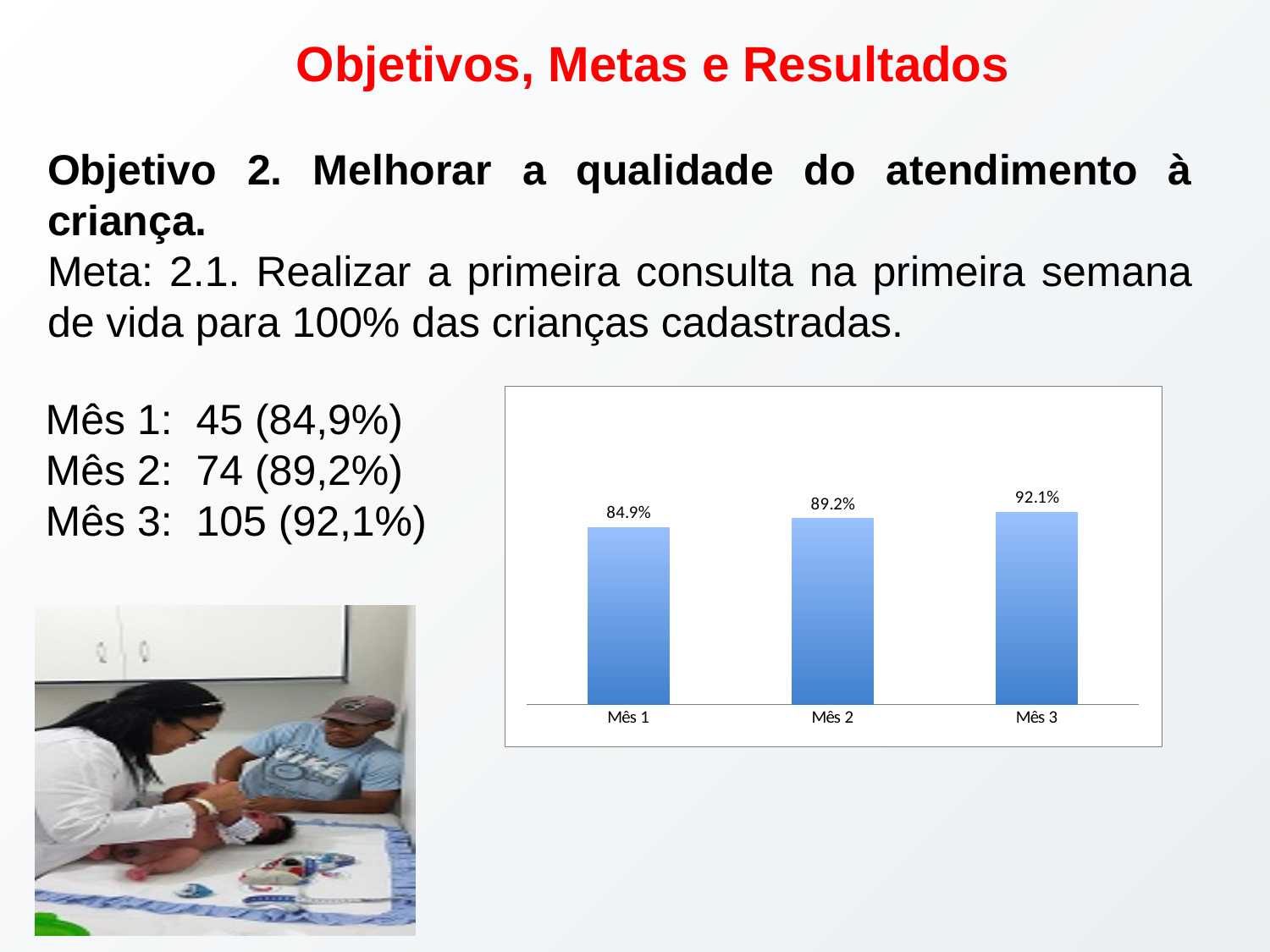
What is the value shown for Mês 3 in the chart? 92.1% Which month has the highest value in the chart? Mês 3 Do the values rise or fall from Mês 1 to Mês 3? Rise What colour are the bars in the chart? Blue Which is larger, the value for Mês 2 or the value for Mês 3? Mês 3 What is the difference between the values for Mês 2 and Mês 1? 4.3% Which month has the lowest value in the chart? Mês 1 What is the value shown for Mês 2 in the chart? 89.2% What kind of chart is shown on the slide? Bar chart What is the value shown for Mês 1 in the chart? 84.9% How many bars are plotted in the chart? 3 What is the difference between the values for Mês 3 and Mês 1? 7.2%